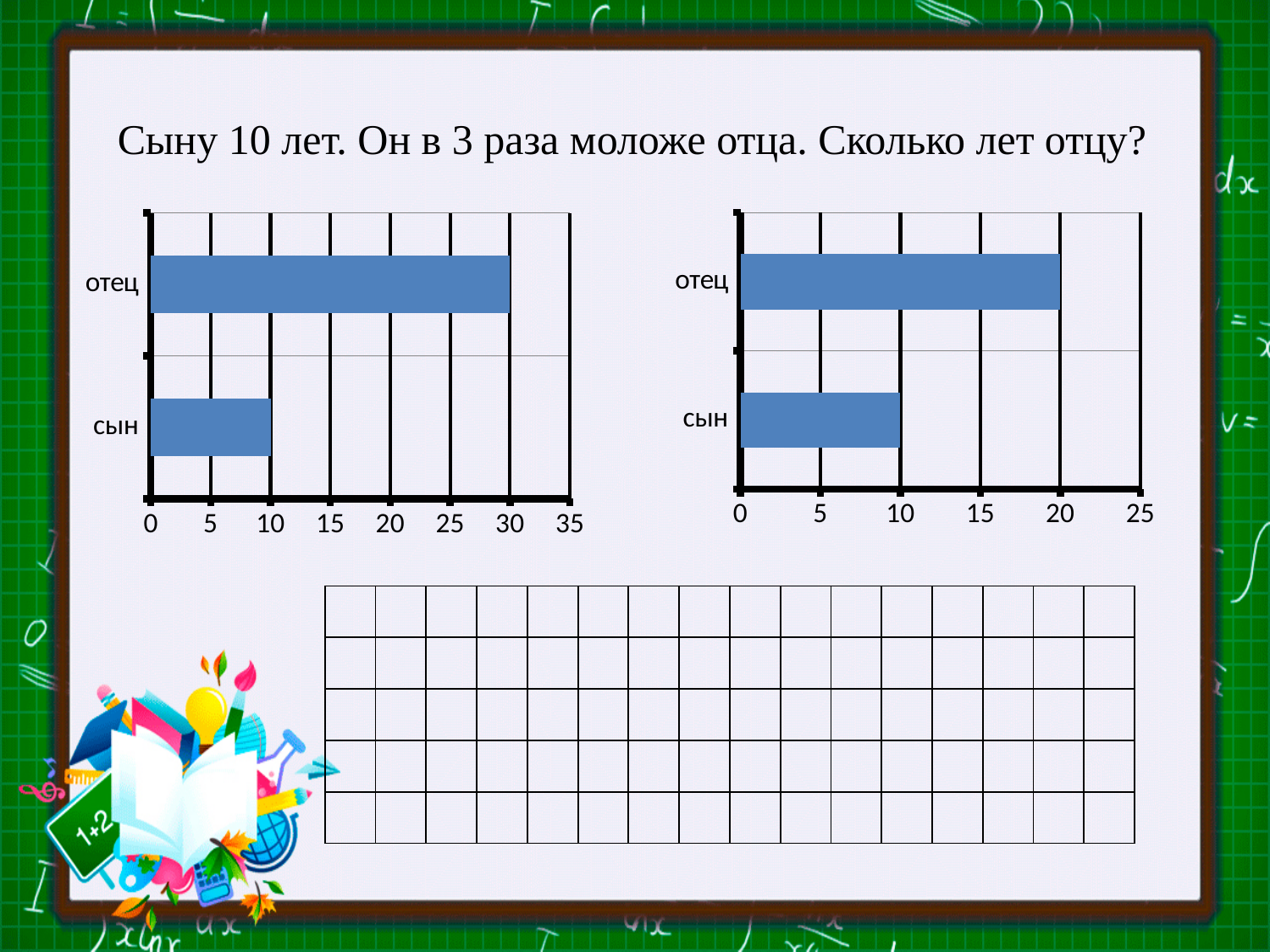
In the right chart, which category has the lowest value? сын In the left chart, which category has the highest value? отец In the left chart, what is the value for сын? 10 In the left chart, what is the value for отец? 30 In the right chart, which is larger, the value for отец or the value for сын? отец In the right chart, what is the value for отец? 20 In the right chart, what is the value for сын? 10 In the right chart, what is the difference between the values for отец and сын? 10 How many categories does the left chart show? 2 In the left chart, what is the difference between the values for отец and сын? 20 What is the highest tick value on the x axis of the left chart? 35 What kind of chart is the right chart? bar chart